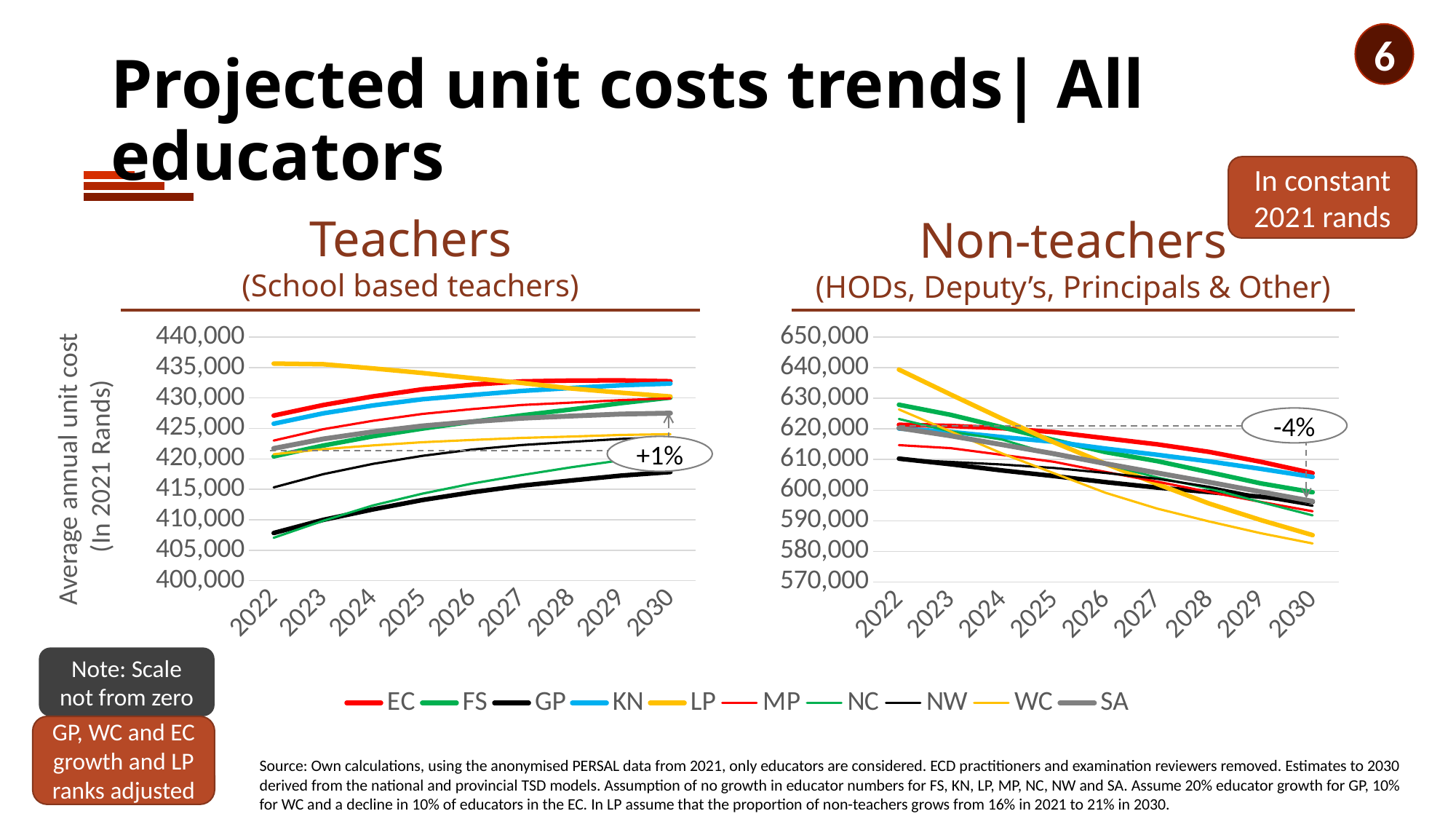
In the Non-teachers chart, does the EC line rise or fall from 2022 to 2030? fall In the Non-teachers chart, is the value for LP in 2022 greater or less than 630,000? greater In the Teachers chart, does the LP line rise or fall from 2022 to 2030? fall In the Non-teachers chart, what percentage change is annotated on the chart? -4% In the Non-teachers chart, which province has the highest average unit cost in 2022? LP How many years are plotted on the x axis of the Non-teachers chart? 9 In the Teachers chart, which province has the lowest average unit cost in 2022? NC What kind of chart is the Teachers chart? line chart In the Teachers chart, what percentage change is annotated on the chart? +1% In the Teachers chart, which province has the highest average unit cost in 2022? LP How many series does the shared legend list? 10 In the Teachers chart, is the value for GP in 2022 greater or less than 410,000? less